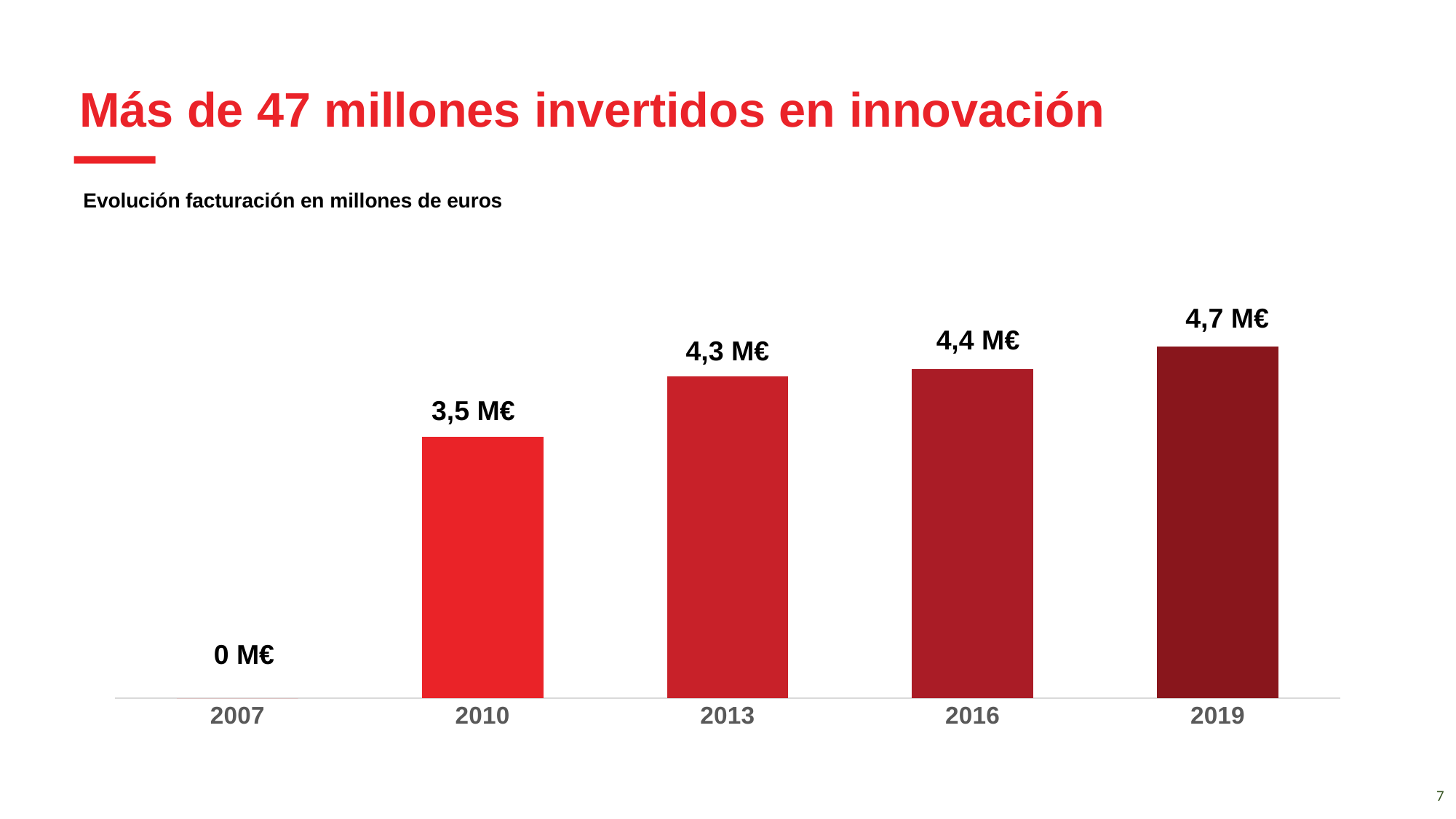
What is the value for 2010? 3,5 M€ Do the values rise or fall from 2007 to 2019? Rise How many years are shown on the x axis? 5 Which year has the highest value? 2019 Which year has the lowest value? 2007 What is the value for 2016? 4,4 M€ What is the value for 2013? 4,3 M€ Which is larger, the value for 2013 or the value for 2019? 2019 What is the value for 2007? 0 M€ What kind of chart is shown on the slide? Bar chart What is the value for 2019? 4,7 M€ What is the difference between the values for 2019 and 2010? 1,2 M€